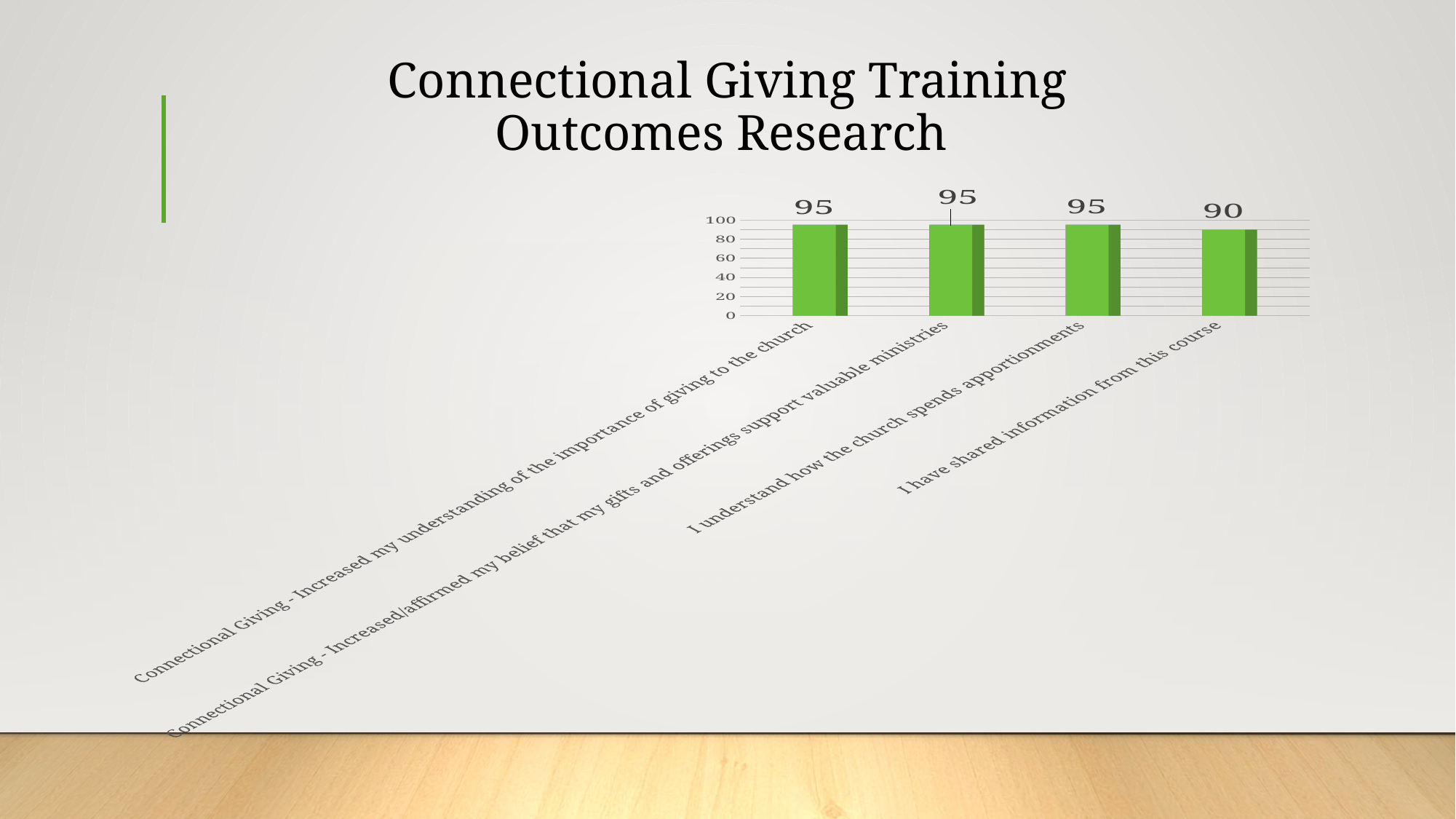
Which is larger: the value for "I understand how the church spends apportionments" or the value for "I have shared information from this course"? I understand how the church spends apportionments What colour are the bars in the chart? green How many categories are shown in the chart? 4 What is the value for "I have shared information from this course"? 90 What is the difference between the value for "I understand how the church spends apportionments" and the value for "I have shared information from this course"? 5 How many categories have a value of 95? 3 What is the value for "Connectional Giving - Increased my understanding of the importance of giving to the church"? 95 What is the highest value shown on the vertical axis? 100 Is the value for "I have shared information from this course" greater or less than 80? greater Which category has the lowest value? I have shared information from this course What is the value for "I understand how the church spends apportionments"? 95 What kind of chart is shown on the slide? bar chart